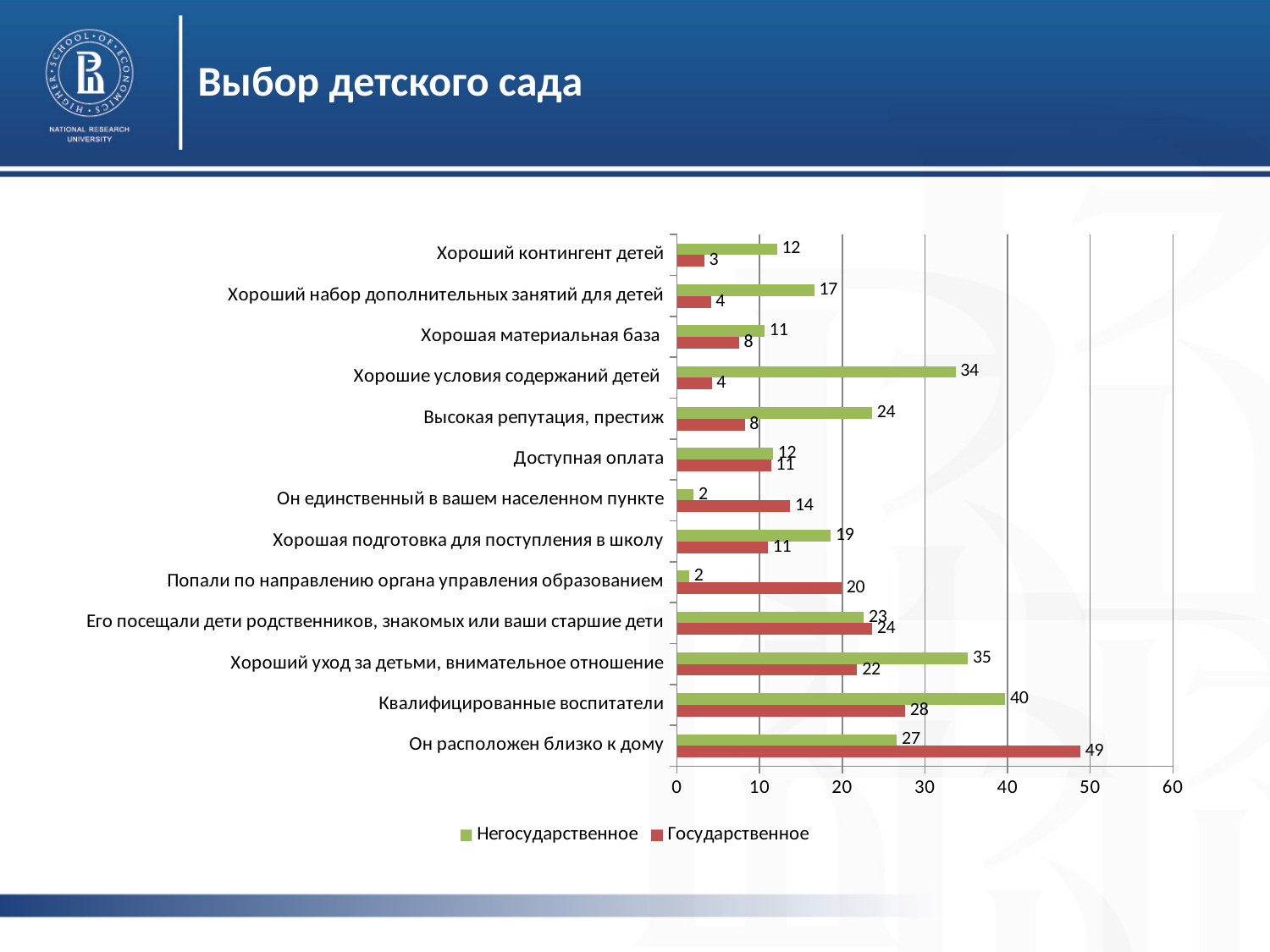
What colour represents the Негосударственное series? green What is the value for Негосударственное for 'Квалифицированные воспитатели'? 40 Which category has the highest value for Негосударственное? Квалифицированные воспитатели What type of chart is shown on the slide? bar chart How many series does the legend list? 2 What is the value for Государственное for 'Он расположен близко к дому'? 49 What is the difference between the Негосударственное and Государственное values for 'Хорошие условия содержаний детей'? 30 For 'Попали по направлению органа управления образованием', which series has the larger value, Негосударственное or Государственное? Государственное What is the difference between the Государственное and Негосударственное values for 'Он расположен близко к дому'? 22 How many categories are shown on the chart? 13 What is the value for Негосударственное for 'Хорошие условия содержаний детей'? 34 Which category has the highest value for Государственное? Он расположен близко к дому